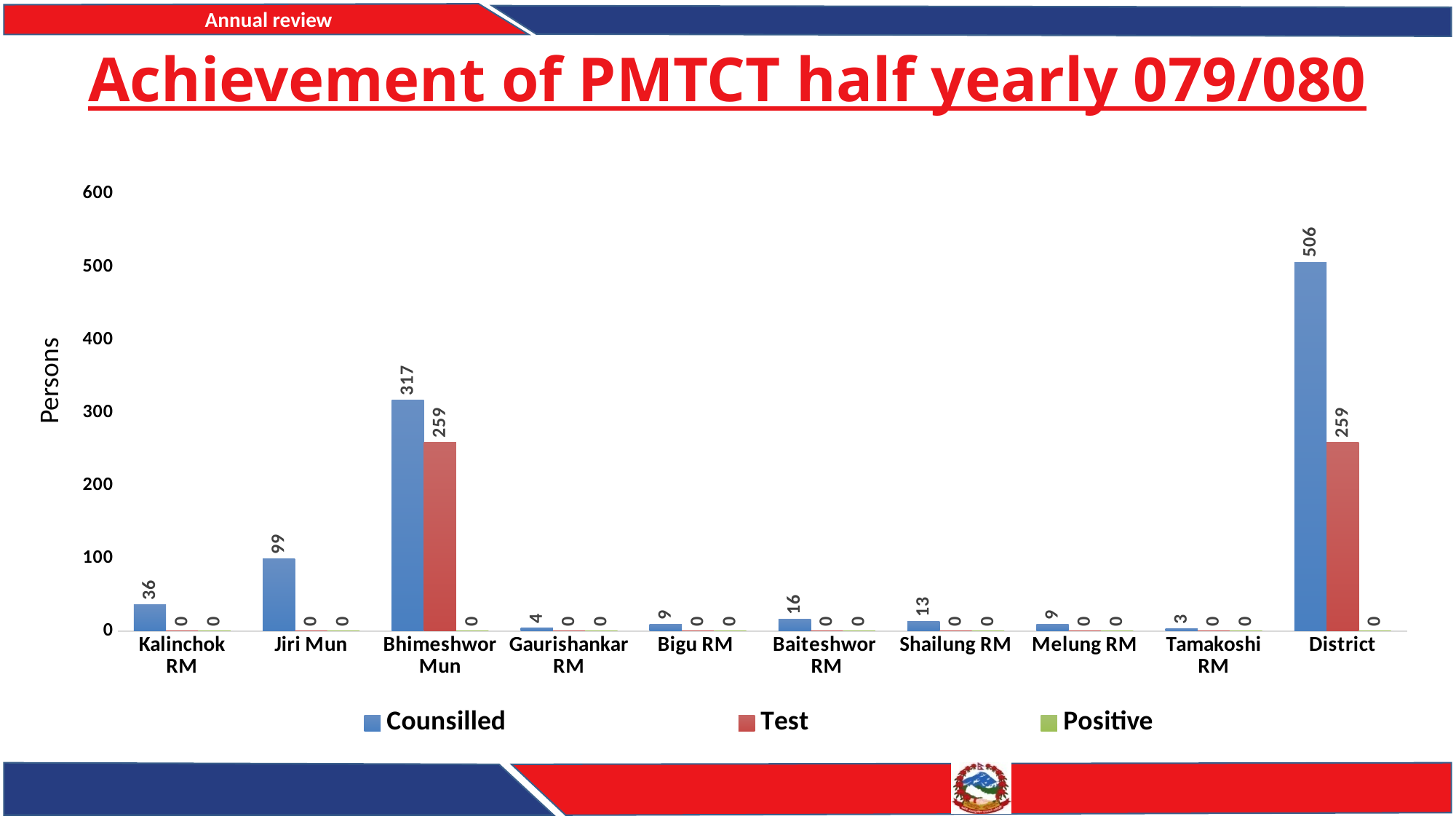
What is the label of the vertical axis? Persons Which is larger, the Counsilled value for Kalinchok RM or the Counsilled value for Baiteshwor RM? Kalinchok RM Which category has the lowest Counsilled value? Tamakoshi RM What is the Test value for District? 259 What is the Positive value for Bhimeshwor Mun? 0 What is the difference between the Counsilled and Test values for Bhimeshwor Mun? 58 What is the Counsilled value for Bhimeshwor Mun? 317 How many categories are shown on the x axis? 10 How many series does the legend list? 3 Excluding the District total, which category has the highest Counsilled value? Bhimeshwor Mun What kind of chart is shown on the slide? Bar chart What is the Counsilled value for Jiri Mun? 99